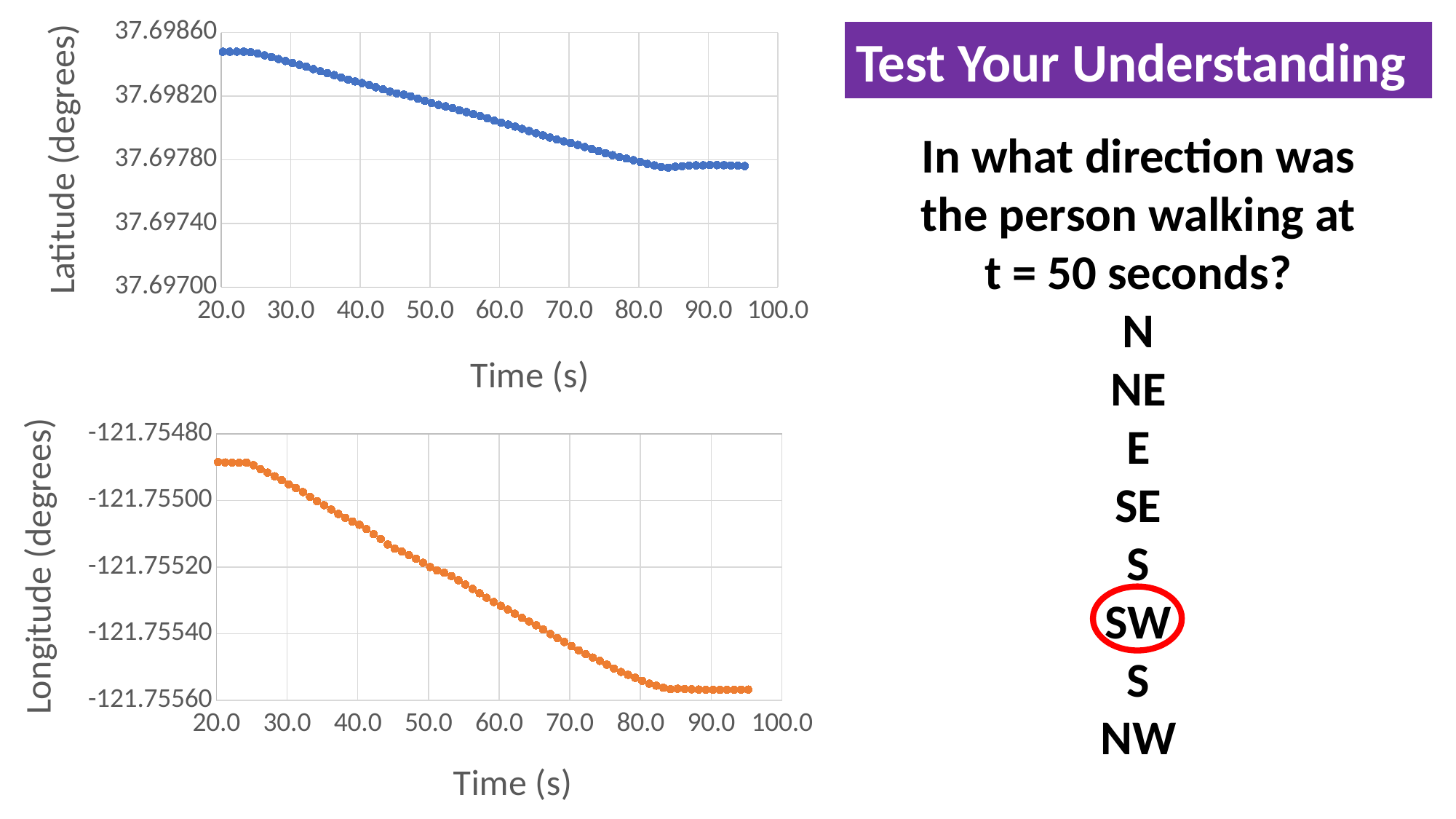
In the top chart, is the latitude at t = 90.0 s greater or less than 37.69800? less In the bottom chart, is the longitude at t = 30.0 s greater or less than -121.75500? greater In the bottom chart, is the longitude at t = 80.0 s greater or less than -121.75540? less What is the y-axis title of the bottom chart? Longitude (degrees) What colour are the data points in the top chart? blue What kind of chart is the top chart (Latitude vs Time)? scatter chart In the top chart, does the latitude rise or fall as time increases from 20 to 80 seconds? fall In the bottom chart, does the longitude rise or fall as time increases from 30 to 80 seconds? fall What kind of chart is the bottom chart (Longitude vs Time)? scatter chart